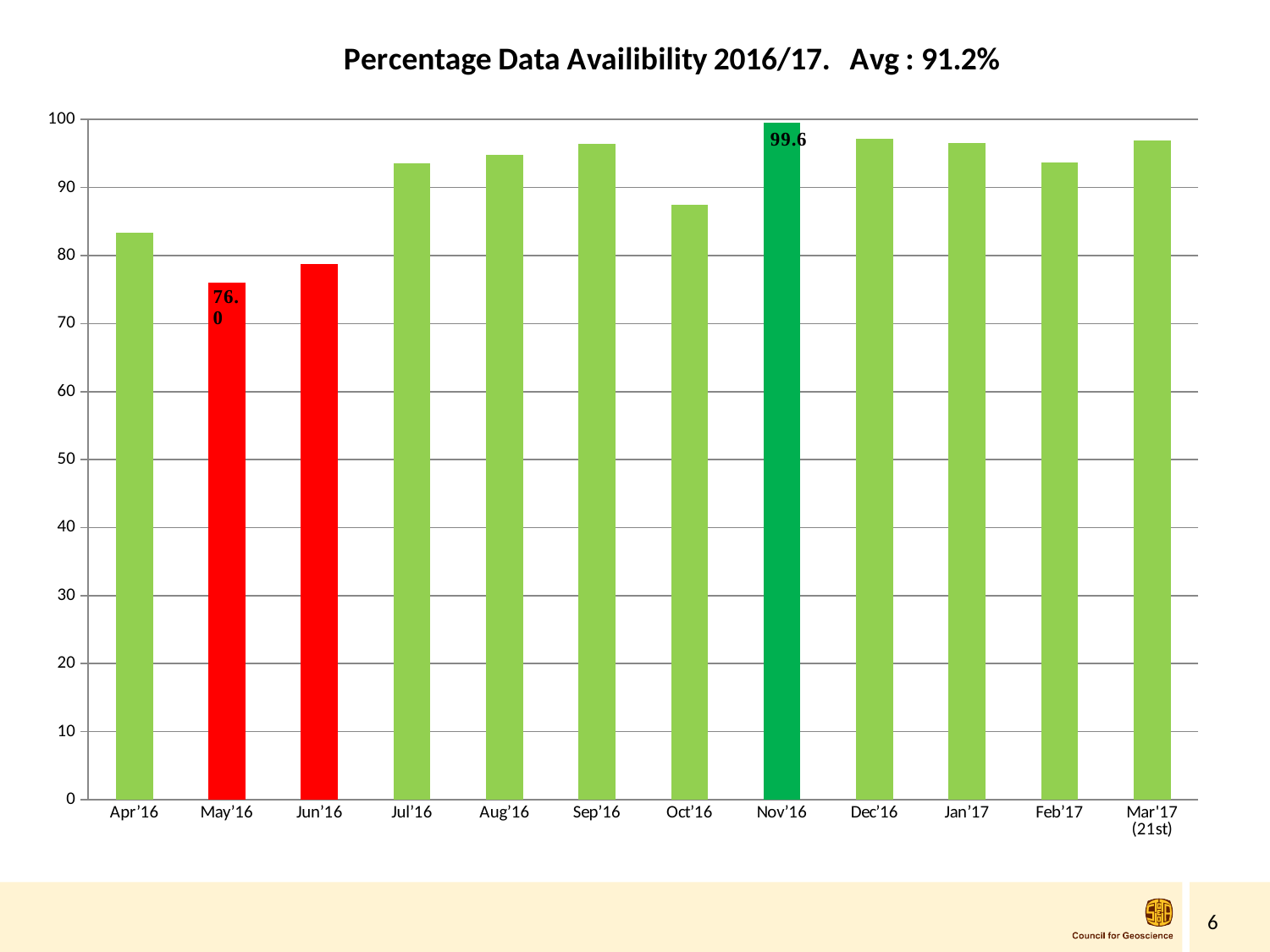
Which is larger, the value for Apr'16 or the value for Jun'16? Apr'16 Which month has the lowest data availability? May'16 Is the value for Jul'16 greater or less than 90? greater What average value is stated in the chart title? 91.2% Which month has the highest data availability? Nov'16 What kind of chart is shown on the slide? bar chart What is the value for May'16? 76.0 Is the value for Oct'16 greater or less than 90? less What is the value for Nov'16? 99.6 What is the difference between the values for Nov'16 and May'16? 23.6 How many months are shown on the x axis? 12 Do the values rise or fall from Jun'16 to Sep'16? rise